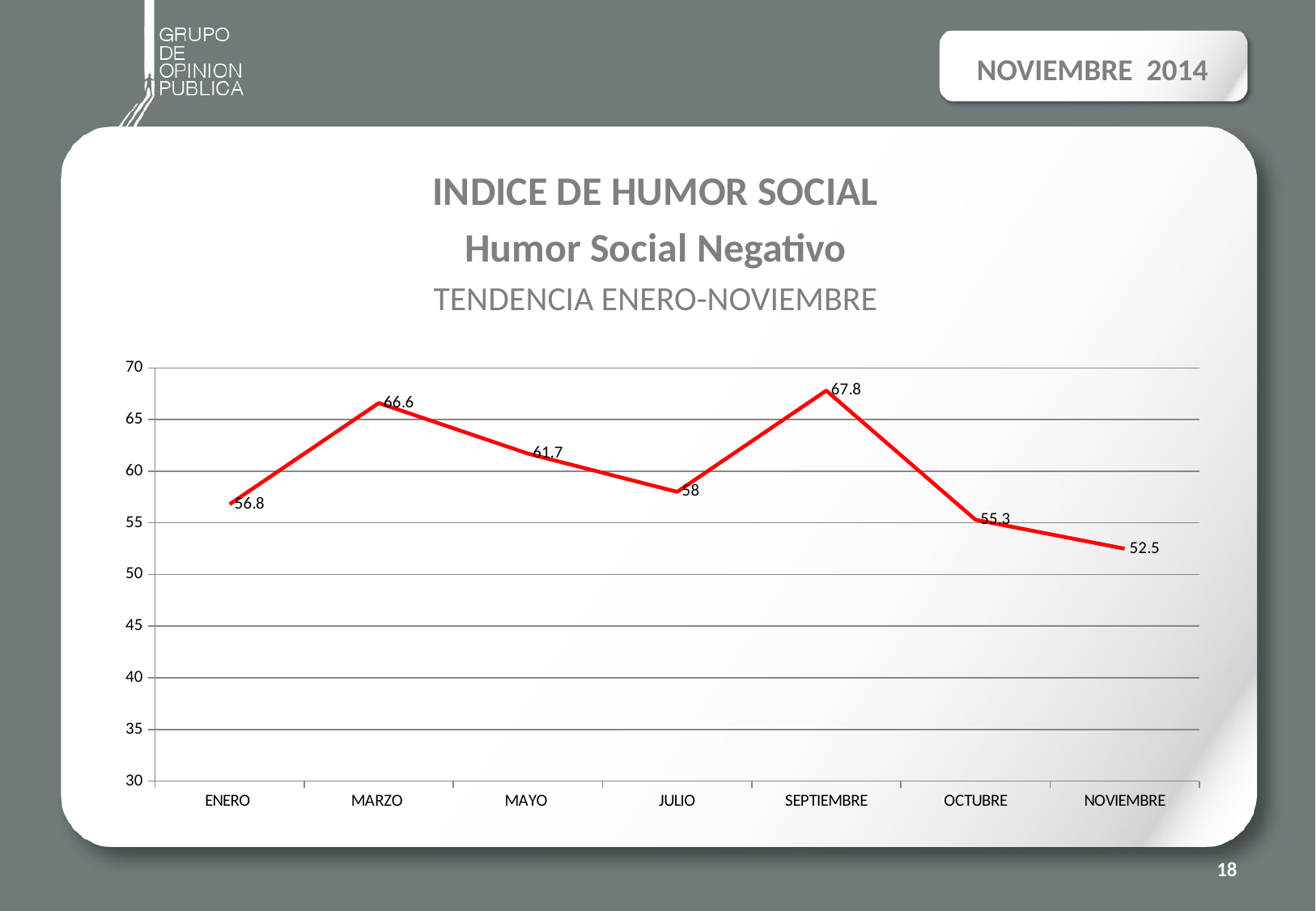
Which month has the lowest value? NOVIEMBRE What is the value for NOVIEMBRE? 52.5 Which month has the highest value? SEPTIEMBRE Do the values rise or fall from SEPTIEMBRE to NOVIEMBRE? fall What kind of chart is shown? line chart What is the value for JULIO? 58 How many months are plotted on the x axis? 7 What is the difference between the values for SEPTIEMBRE and OCTUBRE? 12.5 What colour is the line in the chart? red Which is larger, the value for ENERO or the value for MAYO? MAYO What is the value for MARZO? 66.6 Is the value for OCTUBRE greater or less than 60? less